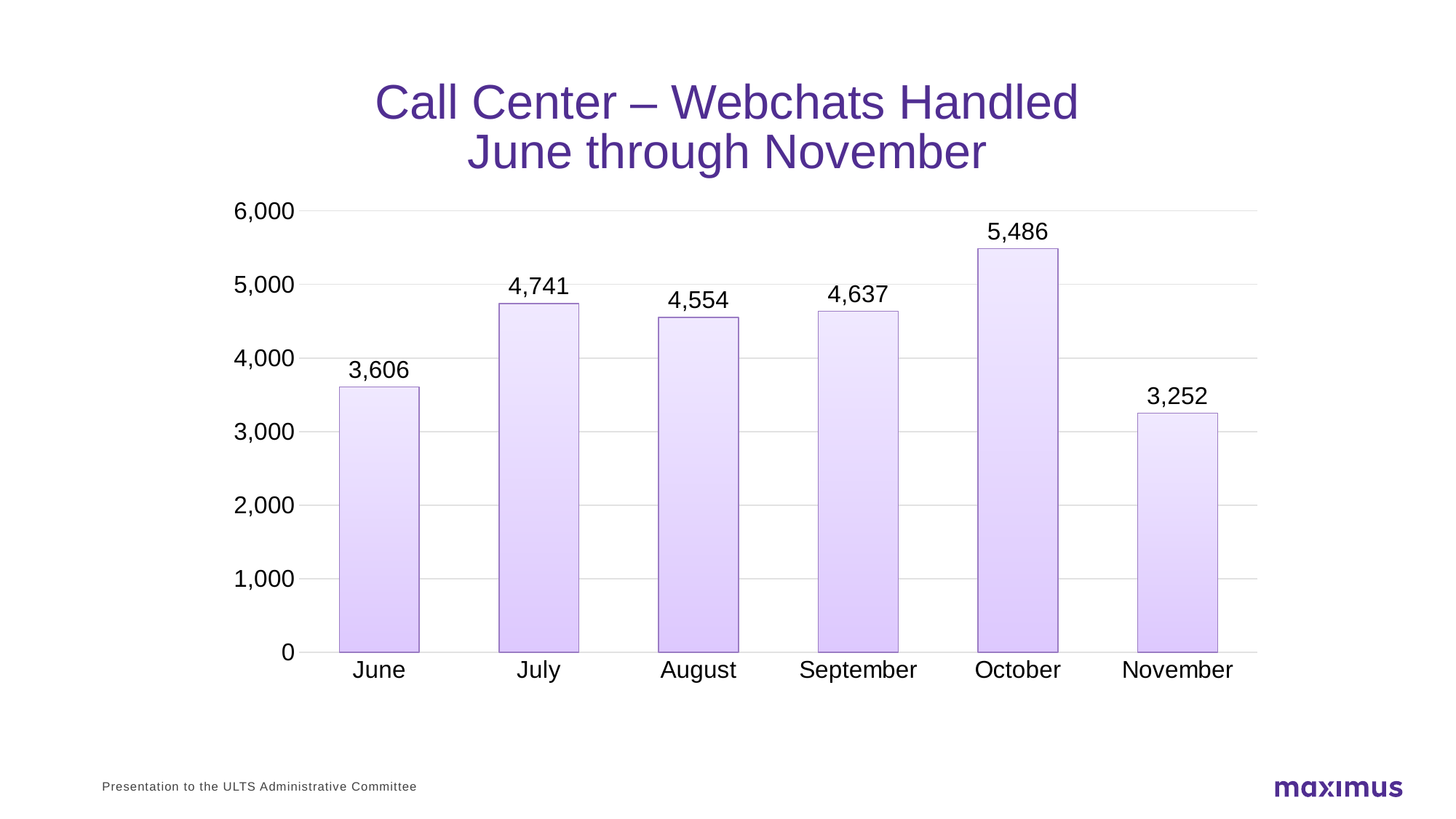
What is the value shown for October? 5,486 Which is larger, the value for July or the value for September? July Which month has the highest number of webchats handled? October Is the value for August greater or less than 4,000? greater How many webchats were handled in September? 4,637 How many webchats were handled in June? 3,606 How many months are shown on the x axis? 6 What is the difference between the values for July and August? 187 Which month has the lowest number of webchats handled? November What is the title of the chart? Call Center – Webchats Handled June through November What kind of chart is shown on the slide? Bar chart What is the difference between the values for October and November? 2,234